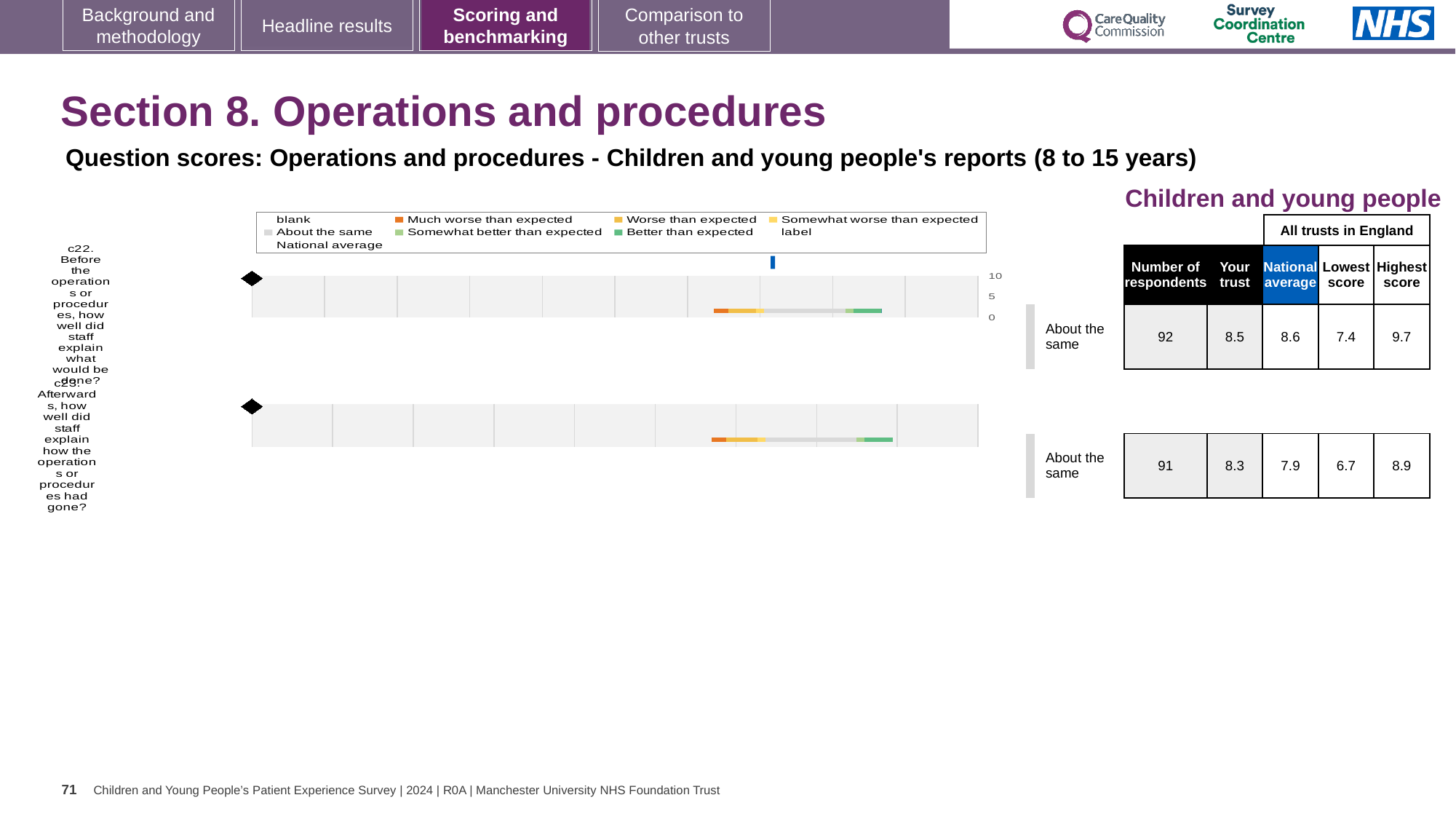
What is the national average score for question c23 (Afterwards, how well did staff explain how the operations or procedures had gone?)? 7.9 What benchmark category is shown for question c22? About the same What is the highest score among all trusts in England for question c23? 8.9 What is the lowest score among all trusts in England for question c22? 7.4 What kind of chart is used to show the question scores on this slide? Bar chart By how much does the trust's score for question c23 exceed the national average? 0.4 How many respondents answered question c22? 92 Which question has the higher 'Your trust' score, c22 or c23? c22 For question c23, which is larger: the trust's score or the national average? Your trust What is the difference between the highest and lowest scores for question c22? 2.3 How many survey questions are charted on this slide? 2 What is the 'Your trust' score for question c22 (Before the operations or procedures, how well did staff explain what would be done?)? 8.5